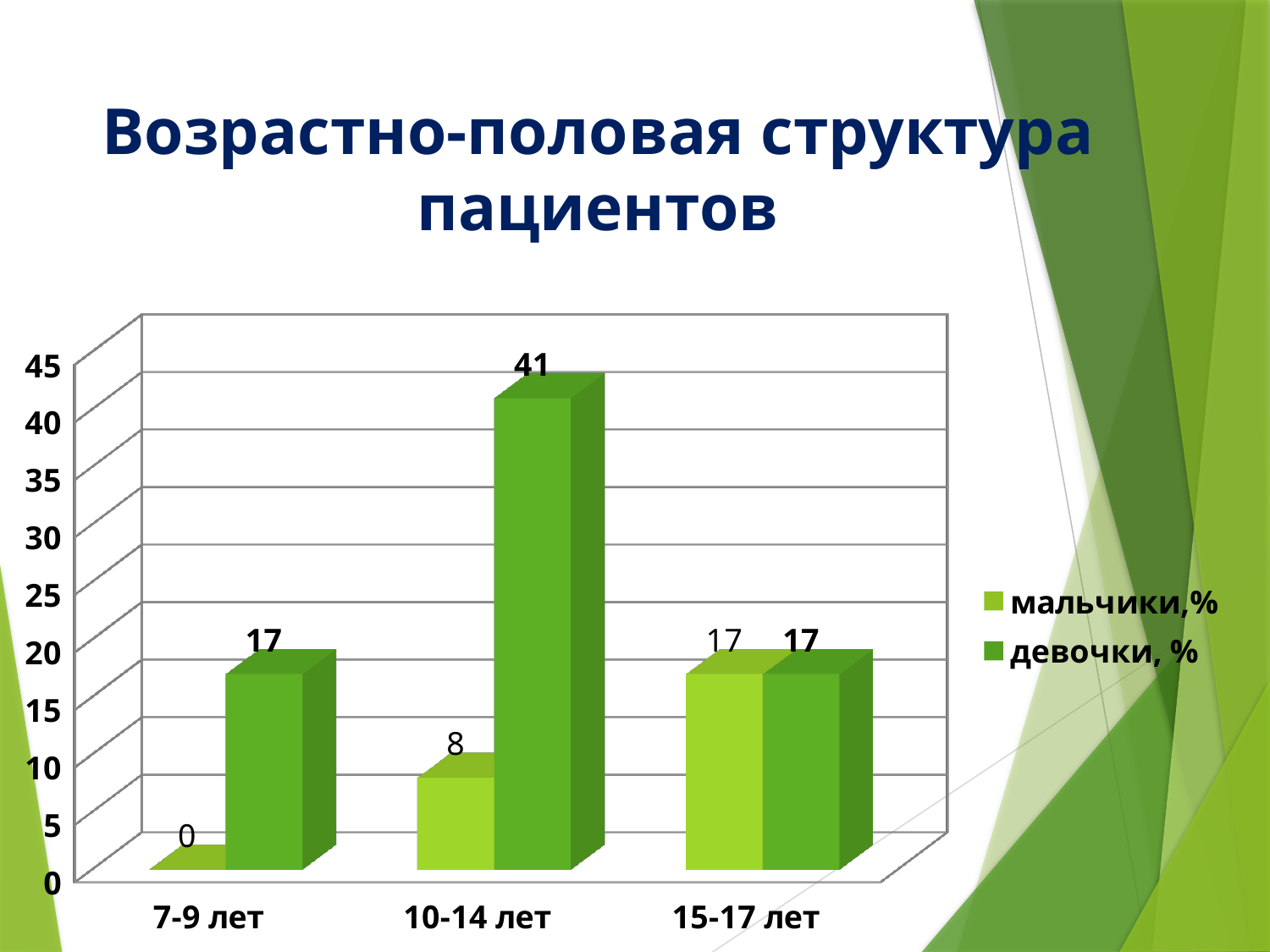
Which age category has the highest value for девочки, %? 10-14 лет What is the title of the slide? Возрастно-половая структура пациентов What is the value for мальчики,% in the 7-9 лет category? 0 What is the value for девочки, % in the 15-17 лет category? 17 What is the difference between девочки, % and мальчики,% in the 10-14 лет category? 33 What is the value for девочки, % in the 10-14 лет category? 41 Which is larger in the 7-9 лет category: мальчики,% or девочки, %? девочки, % What is the value for мальчики,% in the 10-14 лет category? 8 Which age category has the lowest value for мальчики,%? 7-9 лет How many age categories are shown on the x axis? 3 How many series does the legend list? 2 What kind of chart is shown on the slide? bar chart